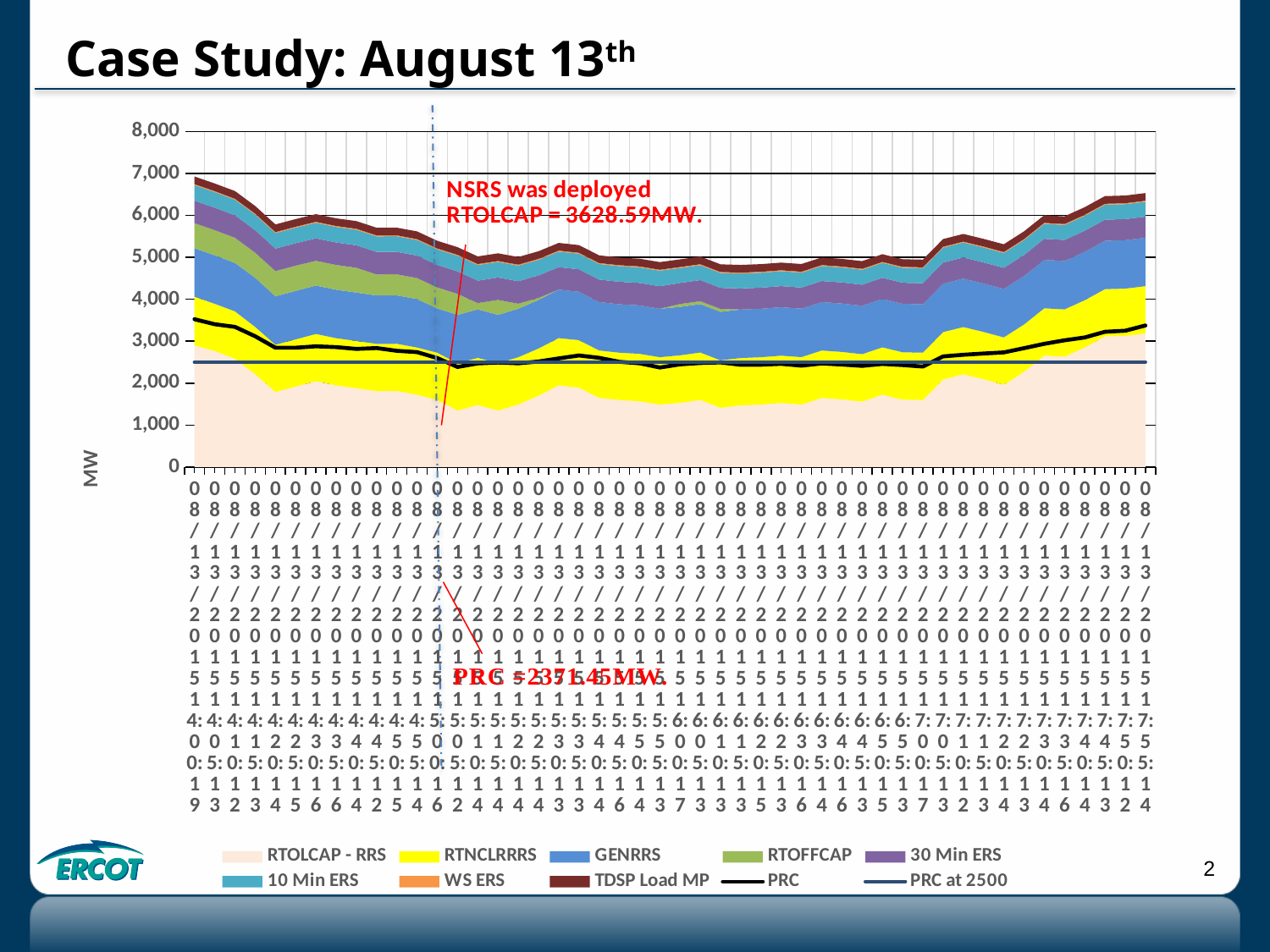
Does the PRC line rise or fall over the first third of the x axis? fall What is the label on the vertical axis? MW Which series is plotted at the bottom of the stacked areas? RTOLCAP - RRS At what level is the horizontal 'PRC at 2500' reference line drawn? 2500 Is the total stacked height at the leftmost point greater or less than 6,000? greater Is the PRC value at the leftmost point of the chart greater or less than 3,000? greater According to the annotation, what was RTOLCAP when NSRS was deployed? 3628.59MW How many series does the legend list? 10 What is the highest tick value shown on the vertical axis? 8,000 Is the lowest point of the PRC line greater or less than 3,000? less What kind of chart is shown on the slide? area chart